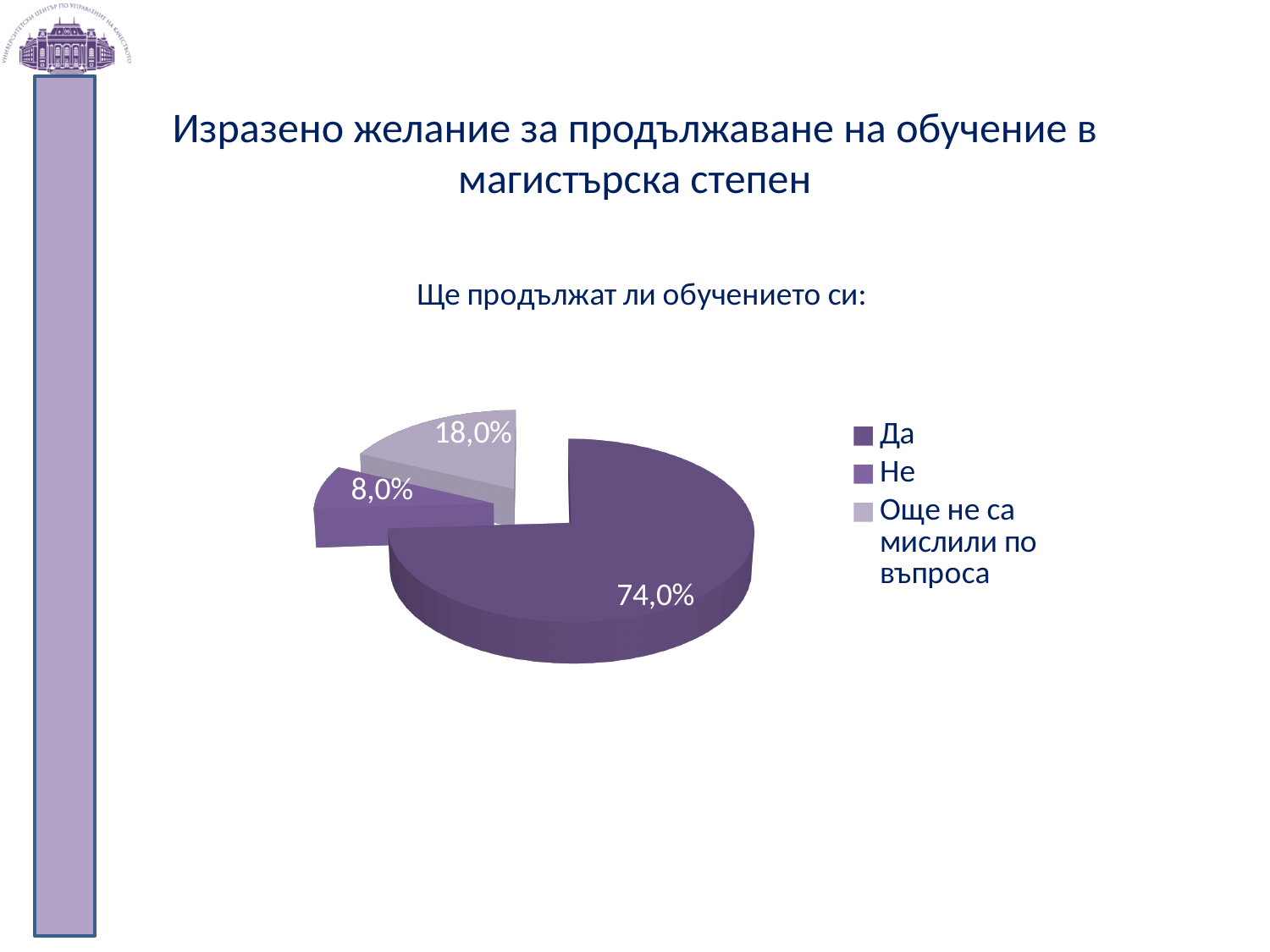
What is the difference between the values for "Още не са мислили по въпроса" and "Не"? 10,0% What kind of chart is shown on the slide? pie chart What is the difference between the values for "Да" and "Не"? 66,0% Which category has the largest share of the pie? Да What is the title of the chart? Ще продължат ли обучението си: Which category has the smallest share of the pie? Не What is the value for "Да"? 74,0% What is the value for "Не"? 8,0% What is the value for "Още не са мислили по въпроса"? 18,0% How many entries does the legend list? 3 Which is larger, the value for "Не" or the value for "Още не са мислили по въпроса"? Още не са мислили по въпроса How many slices does the pie chart have? 3